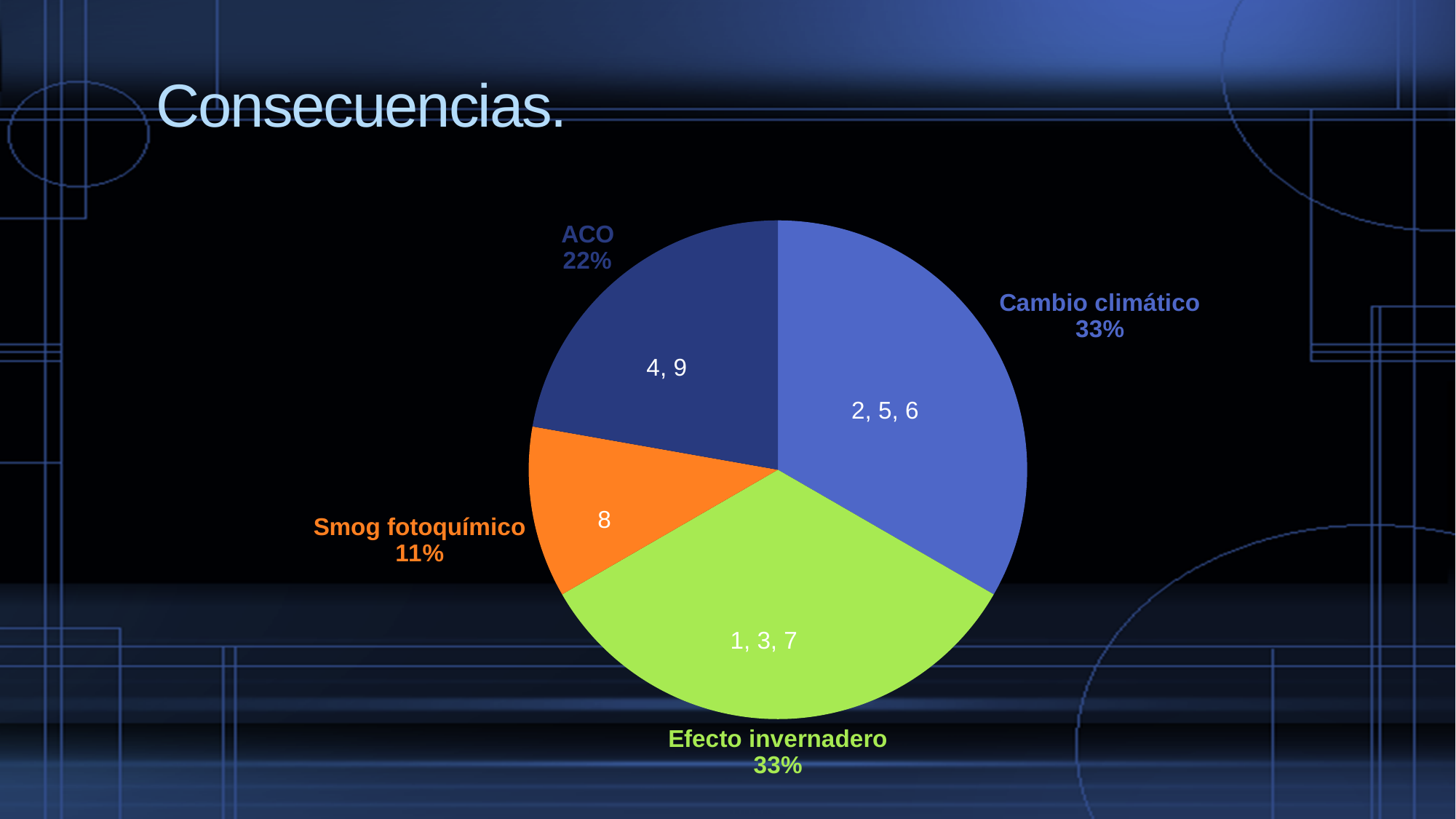
What share of the pie does Cambio climático represent? 33% What share of the pie does Efecto invernadero represent? 33% What share of the pie does ACO represent? 22% What kind of chart is shown on the slide? pie chart What is the difference in percentage points between the Cambio climático slice and the ACO slice? 11 What label is printed inside the Smog fotoquímico slice? 8 How many slices does the pie chart have? 4 What is the title of the slide containing the pie chart? Consecuencias. Which slice of the pie chart is the smallest? Smog fotoquímico Which is larger, the ACO slice or the Smog fotoquímico slice? ACO What is the difference in percentage points between the Efecto invernadero slice and the Smog fotoquímico slice? 22